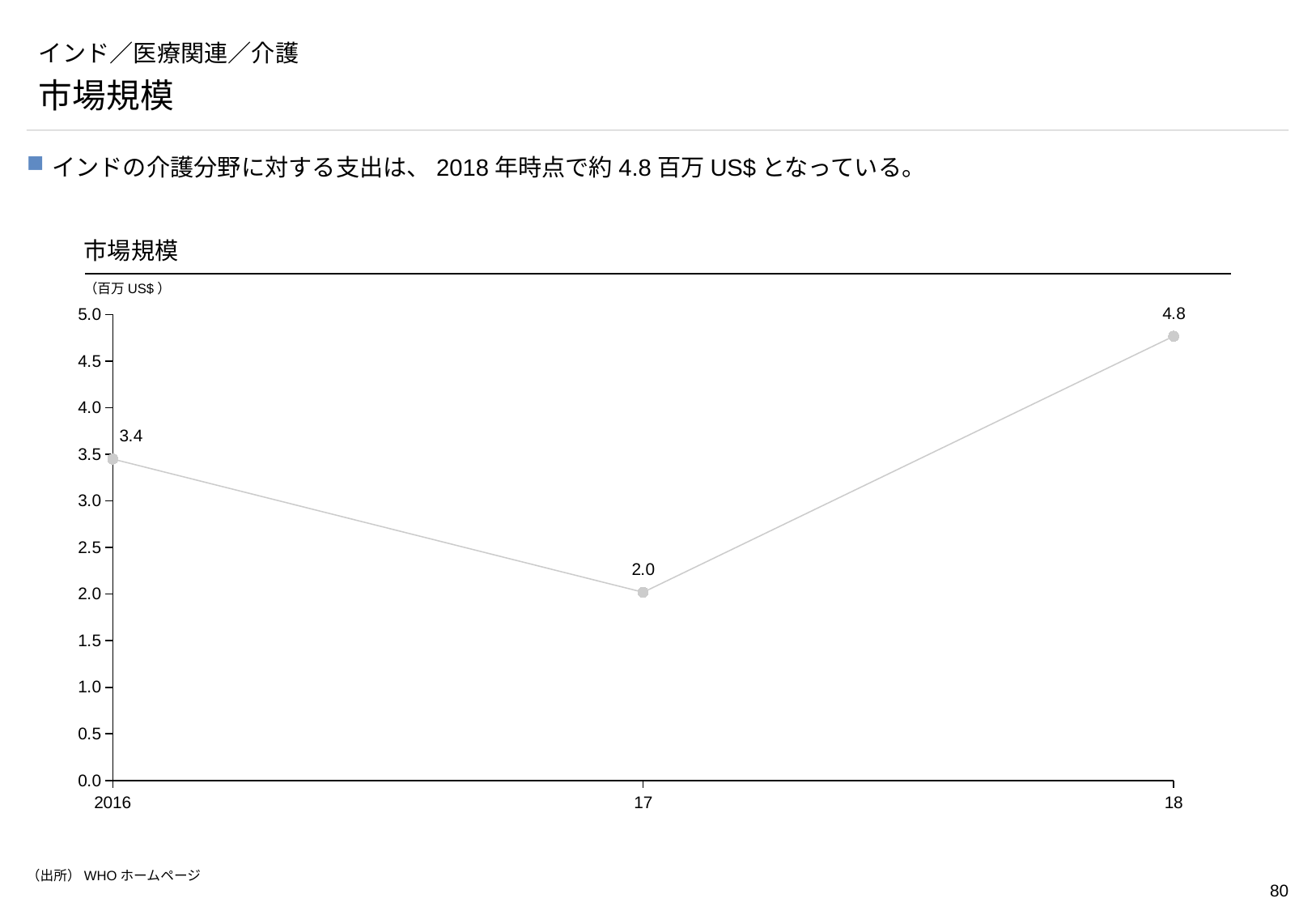
Is the value for 18 greater or less than 4.0? greater Which year has the highest value? 18 What unit is shown for the chart's values? 百万US$ What kind of chart is shown on the slide? line chart What is the value for 18? 4.8 How many data points are plotted on the chart? 3 What is the difference between the values for 2016 and 17? 1.4 What is the value for 17? 2.0 What is the value for 2016? 3.4 Which year has the lowest value? 17 Which is larger, the value for 2016 or the value for 17? 2016 What is the difference between the values for 18 and 2016? 1.4